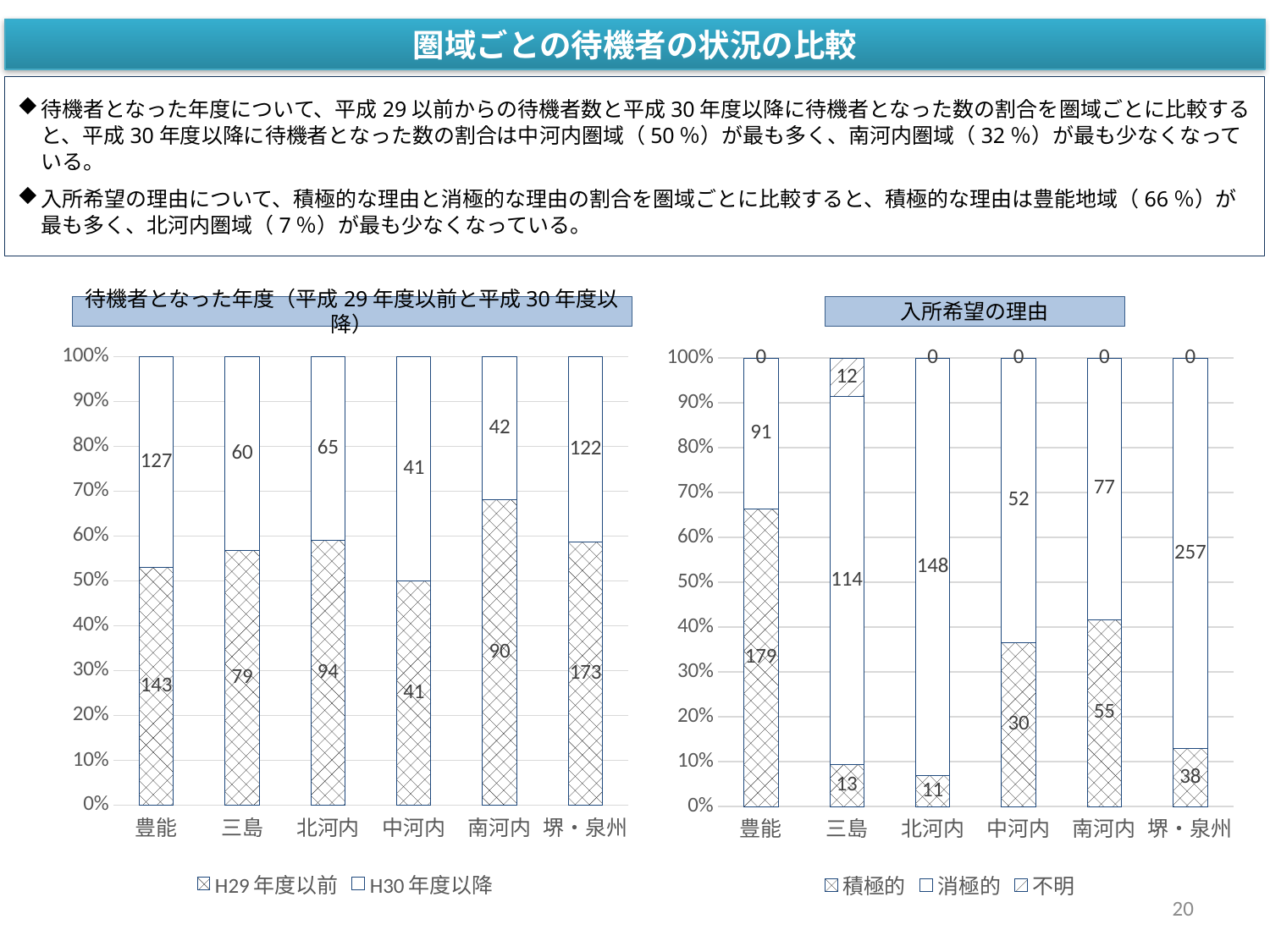
In the right chart (入所希望の理由), which category has the lowest 積極的 value? 北河内 In the right chart (入所希望の理由), what is the 消極的 value for 堺・泉州? 257 In the right chart (入所希望の理由), how many categories are shown on the x axis? 6 In the right chart (入所希望の理由), what is the 積極的 value for 北河内? 11 In the left chart (待機者となった年度), what is the value for H29年度以前 for 豊能? 143 In the left chart (待機者となった年度), which category has the highest H29年度以前 value? 堺・泉州 In the left chart (待機者となった年度), what is the total of the two labelled values for 中河内? 82 In the left chart (待機者となった年度), what is the value for H30年度以降 for 南河内? 42 What kind of chart is the right chart (入所希望の理由)? Stacked bar chart In the left chart (待機者となった年度), how many series does the legend list? 2 In the right chart (入所希望の理由), which is larger for 南河内: the 積極的 value or the 消極的 value? 消極的 In the left chart (待機者となった年度), what is the difference between the H29年度以前 and H30年度以降 values for 堺・泉州? 51